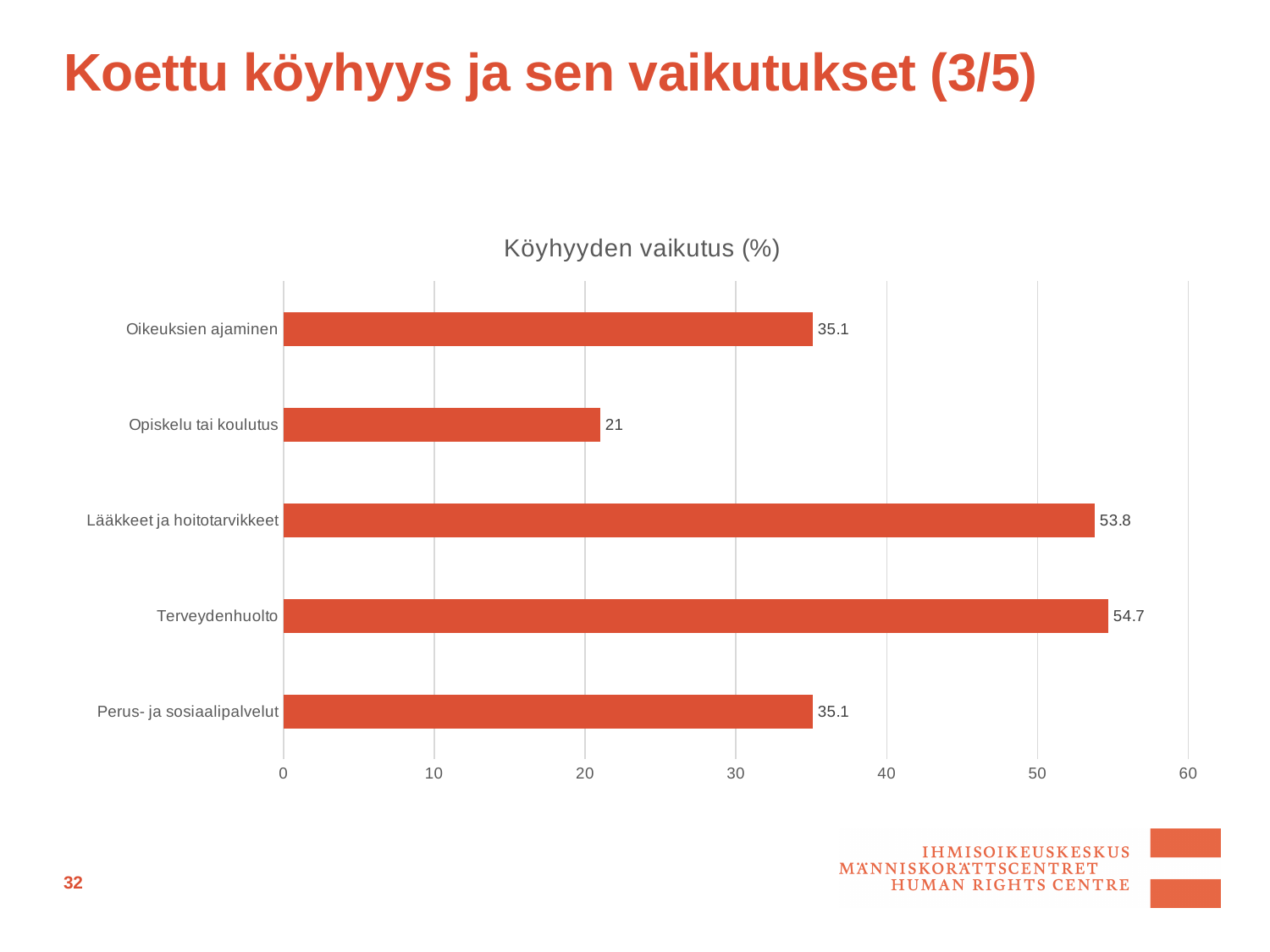
What is the value for Opiskelu tai koulutus? 21 What is the difference between the values for Oikeuksien ajaminen and Opiskelu tai koulutus? 14.1 What is the difference between the values for Terveydenhuolto and Lääkkeet ja hoitotarvikkeet? 0.9 How many categories are shown in the chart? 5 Which is larger, the value for Perus- ja sosiaalipalvelut or the value for Opiskelu tai koulutus? Perus- ja sosiaalipalvelut What is the value for Oikeuksien ajaminen? 35.1 What type of chart is shown on the slide? bar chart What is the value for Lääkkeet ja hoitotarvikkeet? 53.8 Which category has the lowest value? Opiskelu tai koulutus What is the value for Terveydenhuolto? 54.7 Is the value for Lääkkeet ja hoitotarvikkeet greater or less than 50? greater Which category has the highest value? Terveydenhuolto